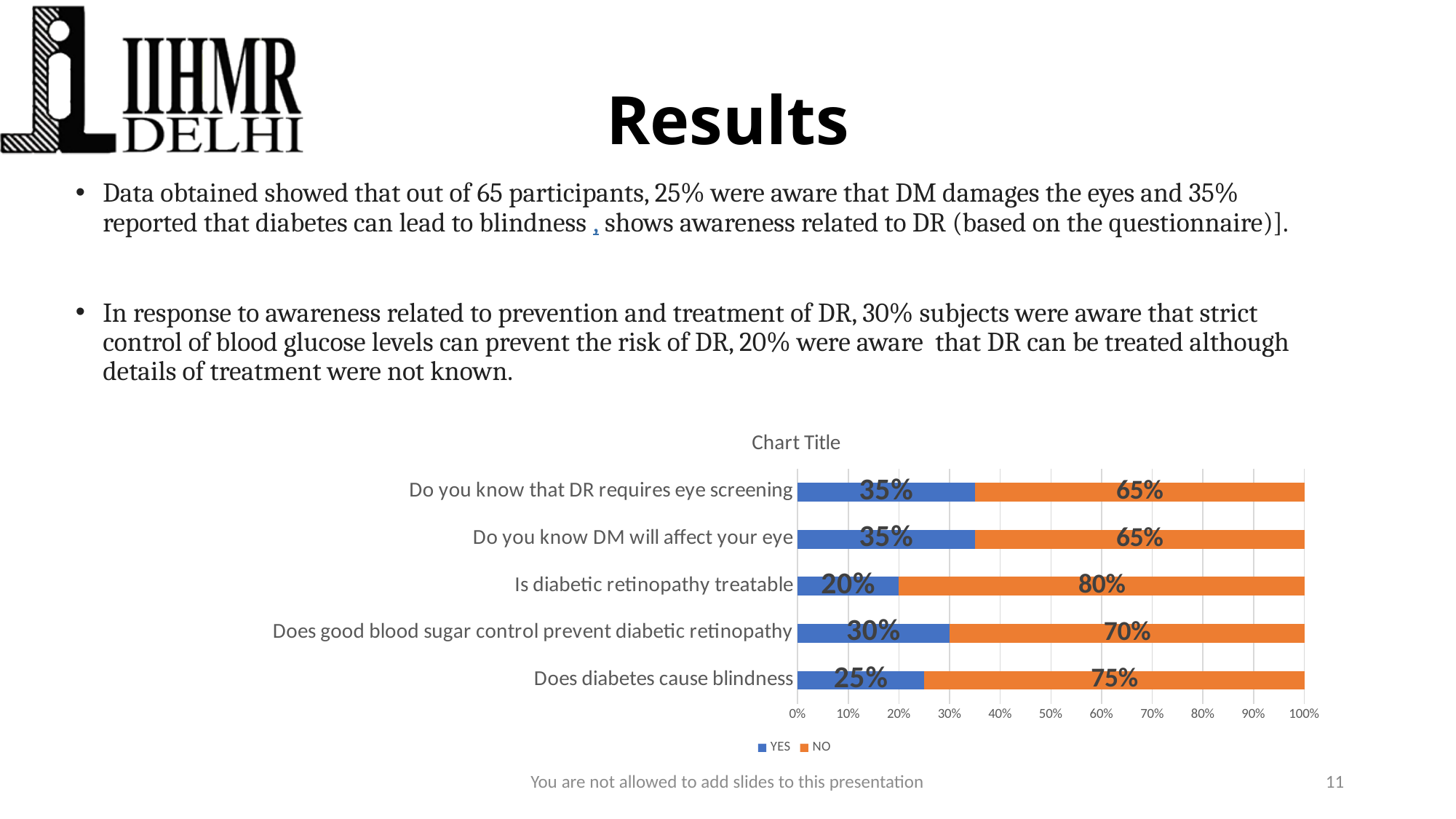
What is the YES value for "Does good blood sugar control prevent diabetic retinopathy"? 30% Which is larger: the YES value for "Does diabetes cause blindness" or the YES value for "Do you know DM will affect your eye"? Do you know DM will affect your eye How many series does the legend list? 2 How many questions (categories) are shown in the chart? 5 Which question has the lowest YES percentage? Is diabetic retinopathy treatable Which colour represents the NO series in the chart? Orange What percentage answered NO to "Does diabetes cause blindness"? 75% Which question has the highest NO percentage? Is diabetic retinopathy treatable What kind of chart is shown on the slide? Stacked bar chart What percentage answered YES to "Is diabetic retinopathy treatable"? 20% What is the total of the YES and NO segments for "Do you know that DR requires eye screening"? 100% What is the difference between the NO and YES percentages for "Is diabetic retinopathy treatable"? 60%